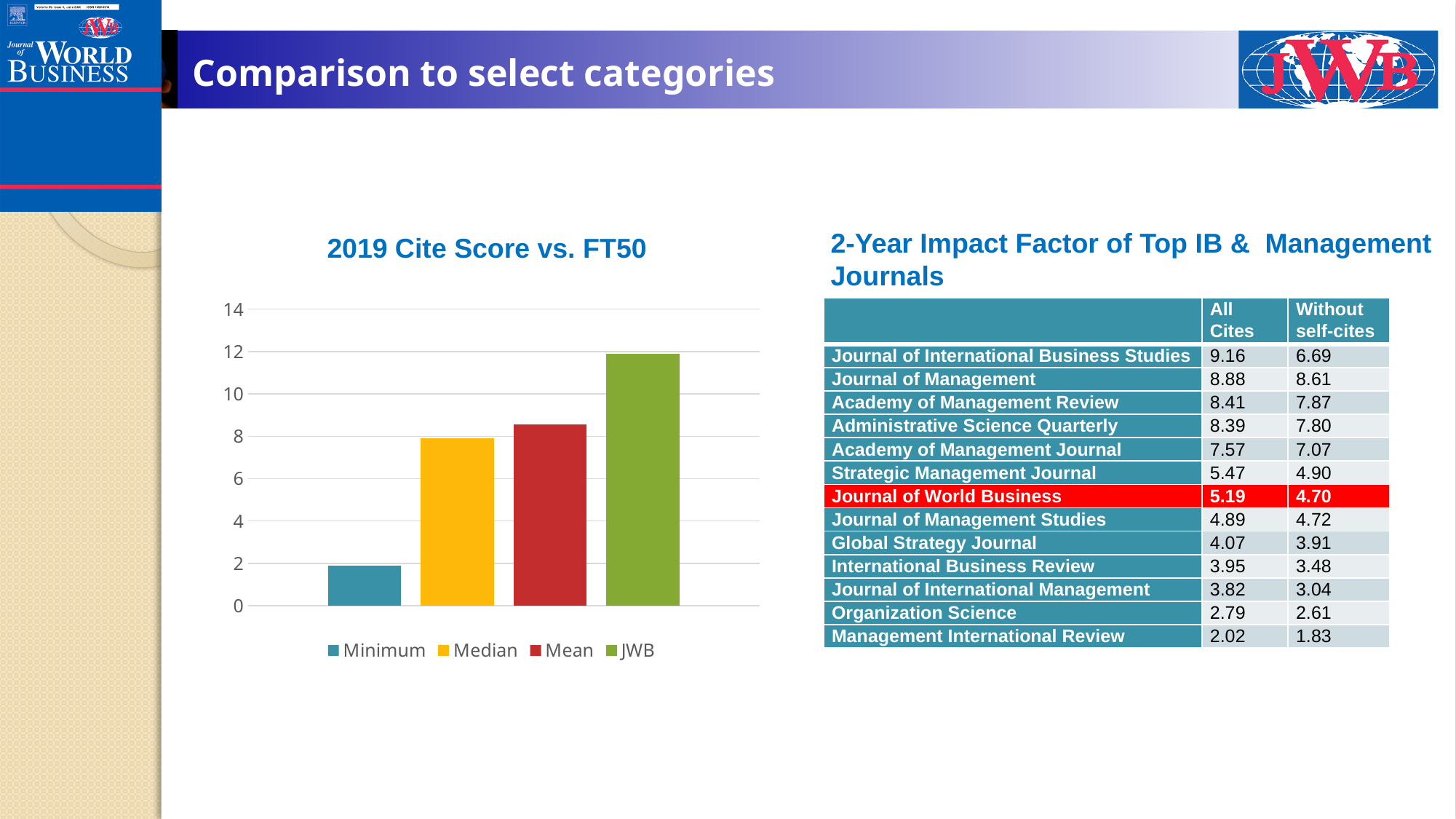
Is the value for Minimum greater or less than 4? less What kind of chart is shown on the slide? bar chart Which is larger in the chart, the Mean bar or the Median bar? Mean Is the value for Mean greater or less than 8? greater Is the value for JWB greater or less than 10? greater Which series has the tallest bar in the chart? JWB Which series has the shortest bar in the chart? Minimum What is the title of the chart on the slide? 2019 Cite Score vs. FT50 How many series does the chart's legend list? 4 Which is larger in the chart, the JWB bar or the Mean bar? JWB What colour is the JWB bar in the chart? green